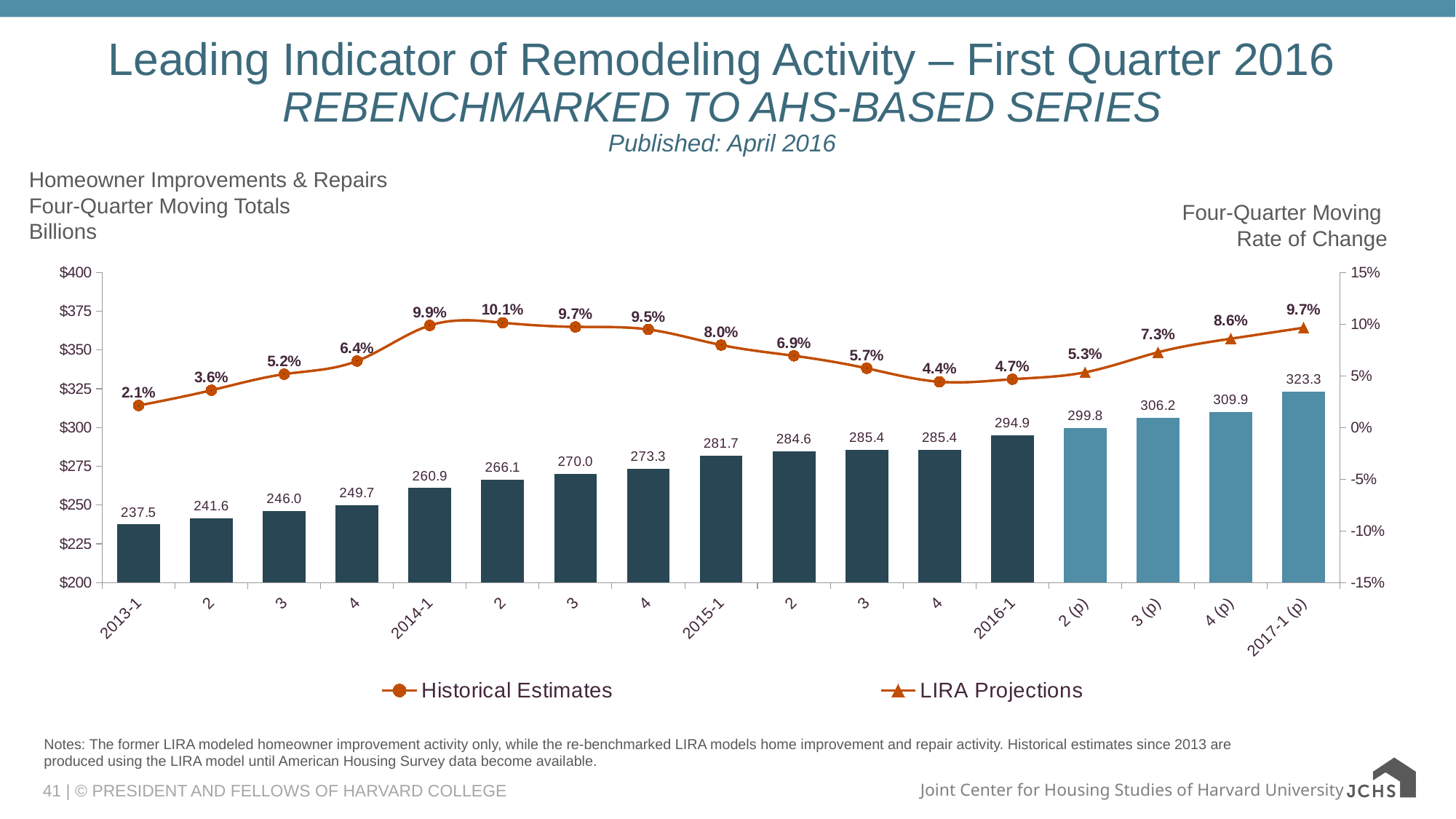
What is the projected four-quarter moving total for 2017-1 (p)? 323.3 Which quarter has the lowest four-quarter moving total? 2013-1 How many series does the legend list? 2 What kind of chart is this? Combined bar and line chart What are the two series named in the legend? Historical Estimates and LIRA Projections How many quarters are plotted along the x axis? 17 What is the difference between the four-quarter moving totals for 2017-1 (p) and 2016-1? 28.4 Which quarter has the highest four-quarter moving rate of change? 2014-2 What rate of change is labeled for 2014-2? 10.1% Which is larger, the rate of change for 2015-4 or for 2016-1? 2016-1 What is the four-quarter moving total (in billions) shown for 2016-1? 294.9 Do the four-quarter moving totals rise or fall from 2013-1 to 2017-1 (p)? Rise